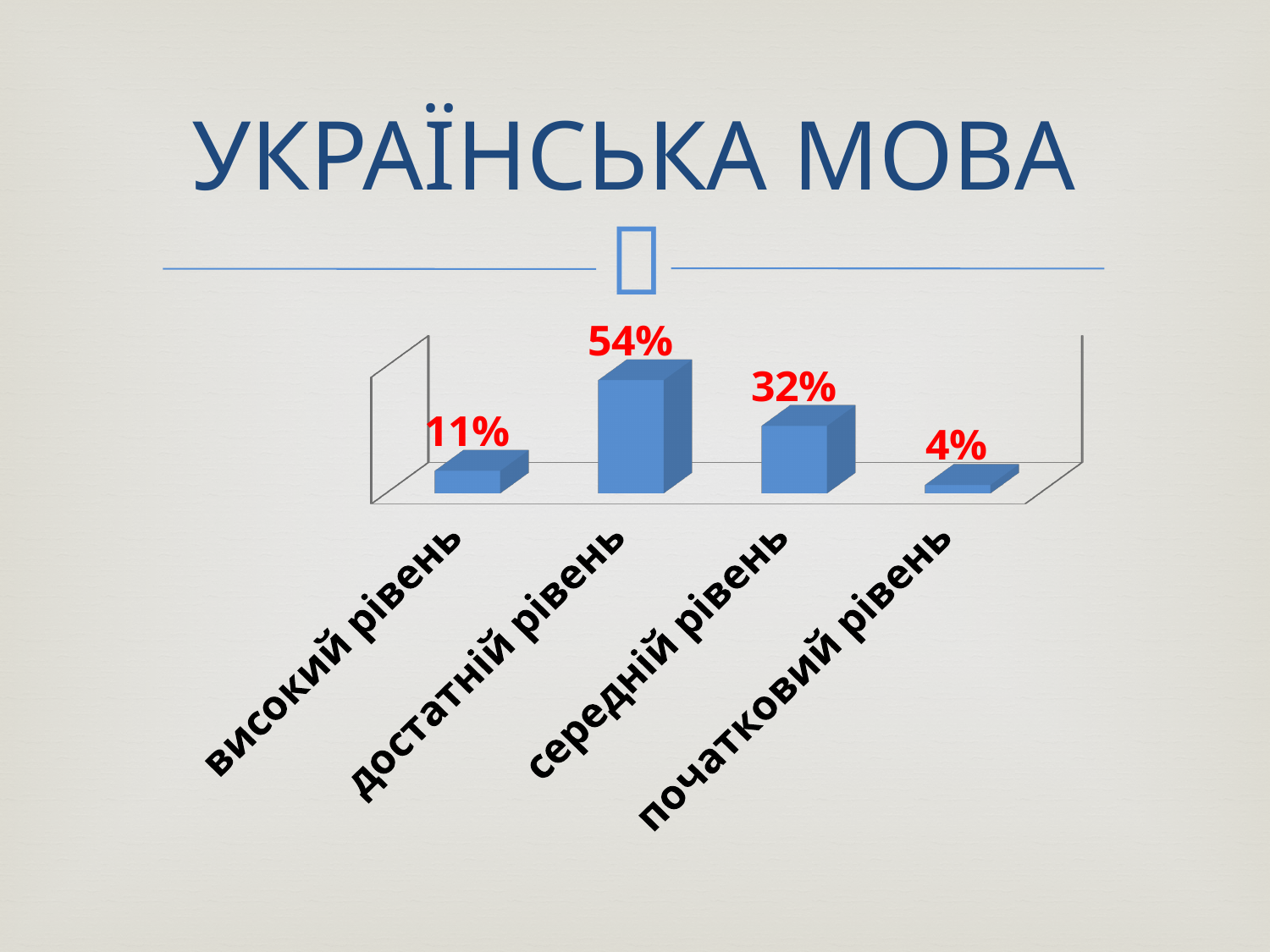
What is the difference between the values for достатній рівень and середній рівень? 22% What is the value for початковий рівень? 4% What is the value for високий рівень? 11% What is the difference between the values for високий рівень and початковий рівень? 7% What kind of chart is shown on the slide? bar chart How many categories are shown in the chart? 4 Which category has the lowest value? початковий рівень What is the value for середній рівень? 32% What is the value for достатній рівень? 54% What is the title of the slide containing the chart? УКРАЇНСЬКА МОВА Which is larger, the value for високий рівень or the value for середній рівень? середній рівень Which category has the highest value? достатній рівень